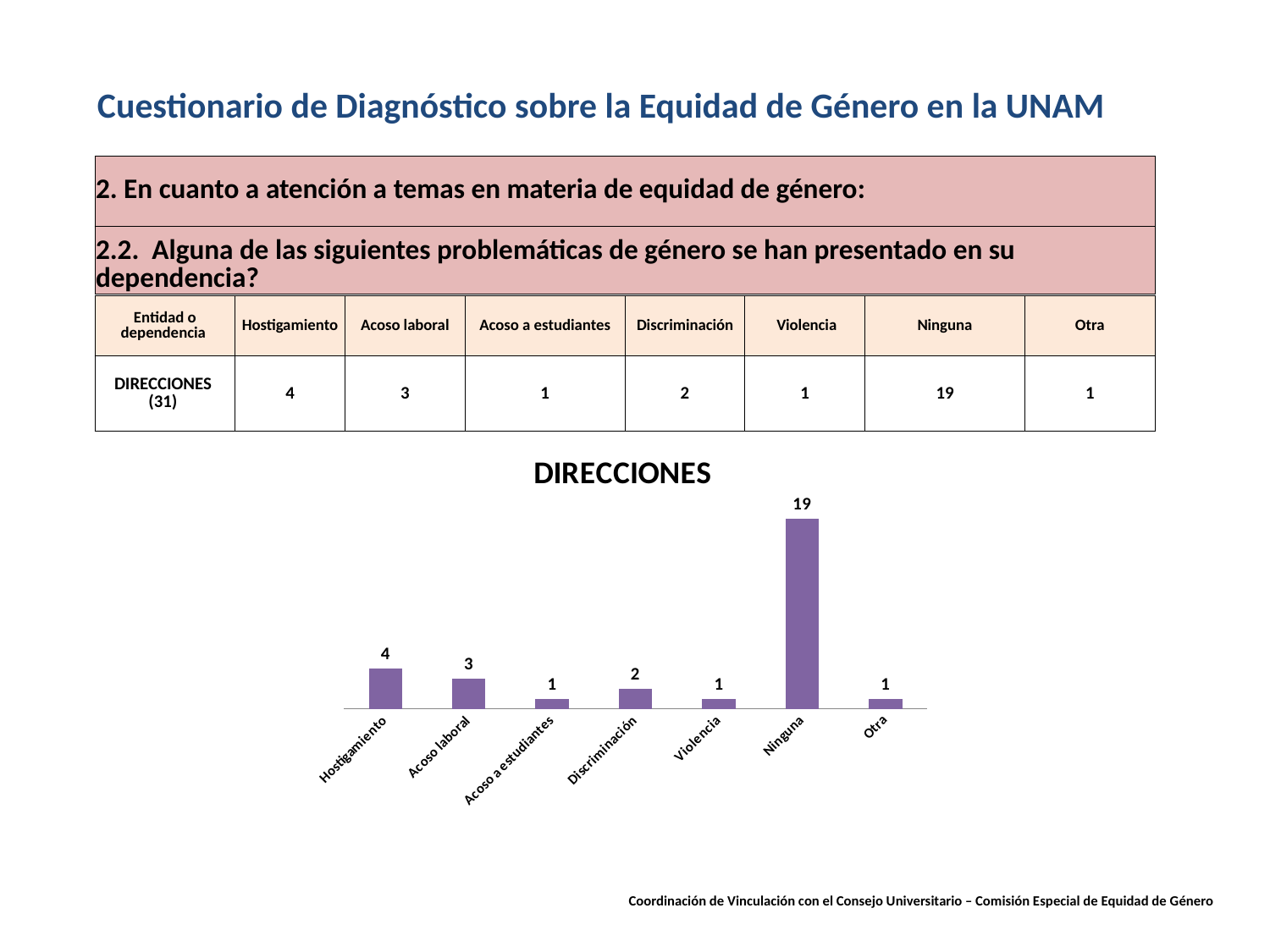
How many categories in the DIRECCIONES chart have a value of 1? 3 What is the value for Ninguna in the DIRECCIONES chart? 19 What is the title of the chart on the slide? DIRECCIONES What is the value for Hostigamiento in the DIRECCIONES chart? 4 What kind of chart is the DIRECCIONES chart? Bar chart What is the value for Discriminación in the DIRECCIONES chart? 2 Which category has the highest value in the DIRECCIONES chart? Ninguna Which is larger in the DIRECCIONES chart, the value for Discriminación or the value for Violencia? Discriminación What is the difference between the values for Hostigamiento and Acoso laboral in the DIRECCIONES chart? 1 What is the difference between the values for Ninguna and Hostigamiento in the DIRECCIONES chart? 15 How many categories are shown on the x axis of the DIRECCIONES chart? 7 What is the value for Acoso laboral in the DIRECCIONES chart? 3